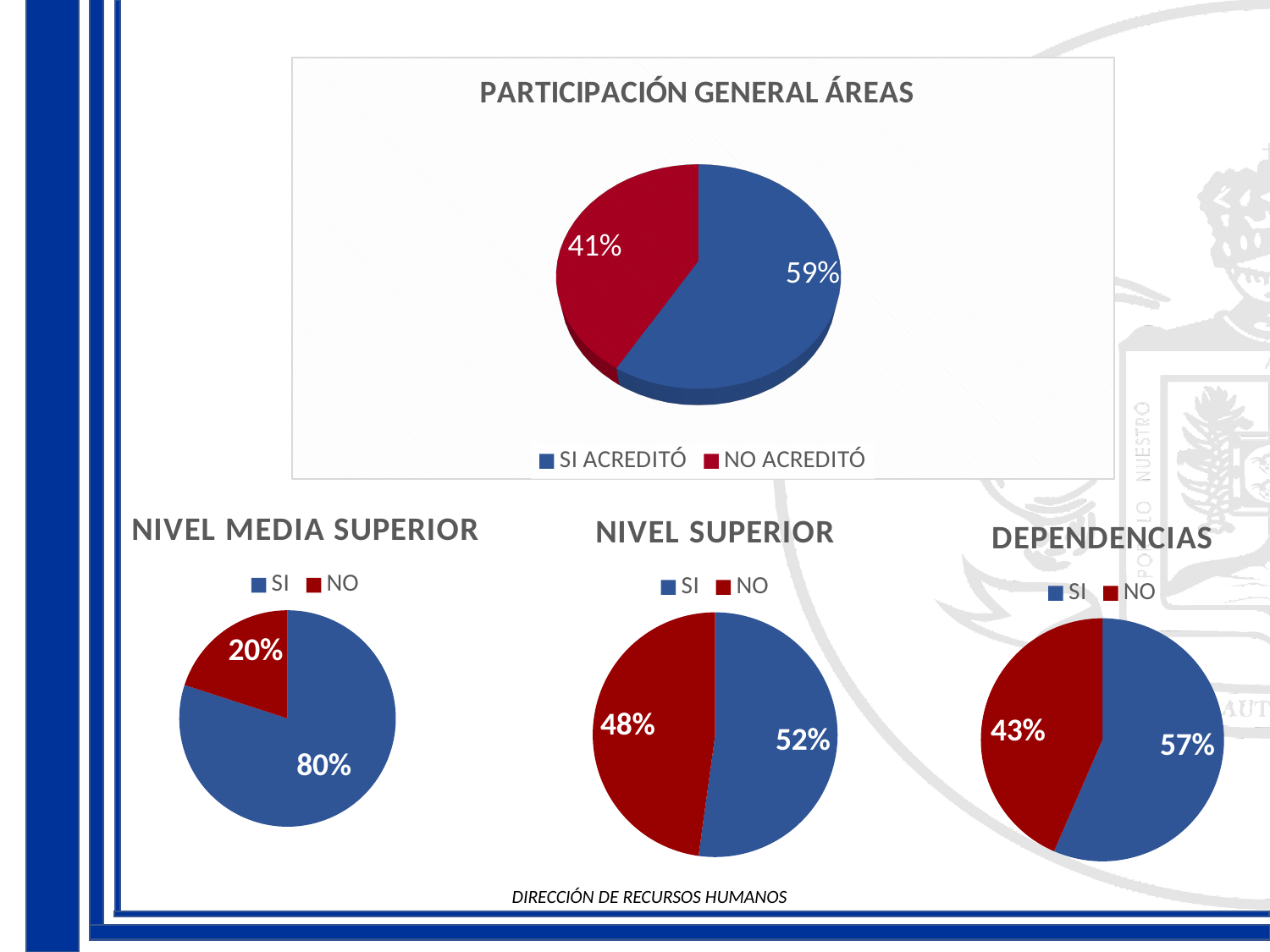
In the NIVEL MEDIA SUPERIOR chart, what is the difference between the SI and NO shares? 60% In the DEPENDENCIAS chart, what is the difference between the SI and NO shares? 14% In the NIVEL SUPERIOR chart, what share is labelled for SI? 52% In the PARTICIPACIÓN GENERAL ÁREAS chart, which slice is larger, SI ACREDITÓ or NO ACREDITÓ? SI ACREDITÓ What kind of chart is the PARTICIPACIÓN GENERAL ÁREAS chart? Pie chart In the PARTICIPACIÓN GENERAL ÁREAS chart, what share is labelled for SI ACREDITÓ? 59% How many entries does the legend of the PARTICIPACIÓN GENERAL ÁREAS chart list? 2 In the DEPENDENCIAS chart, what share is labelled for NO? 43%